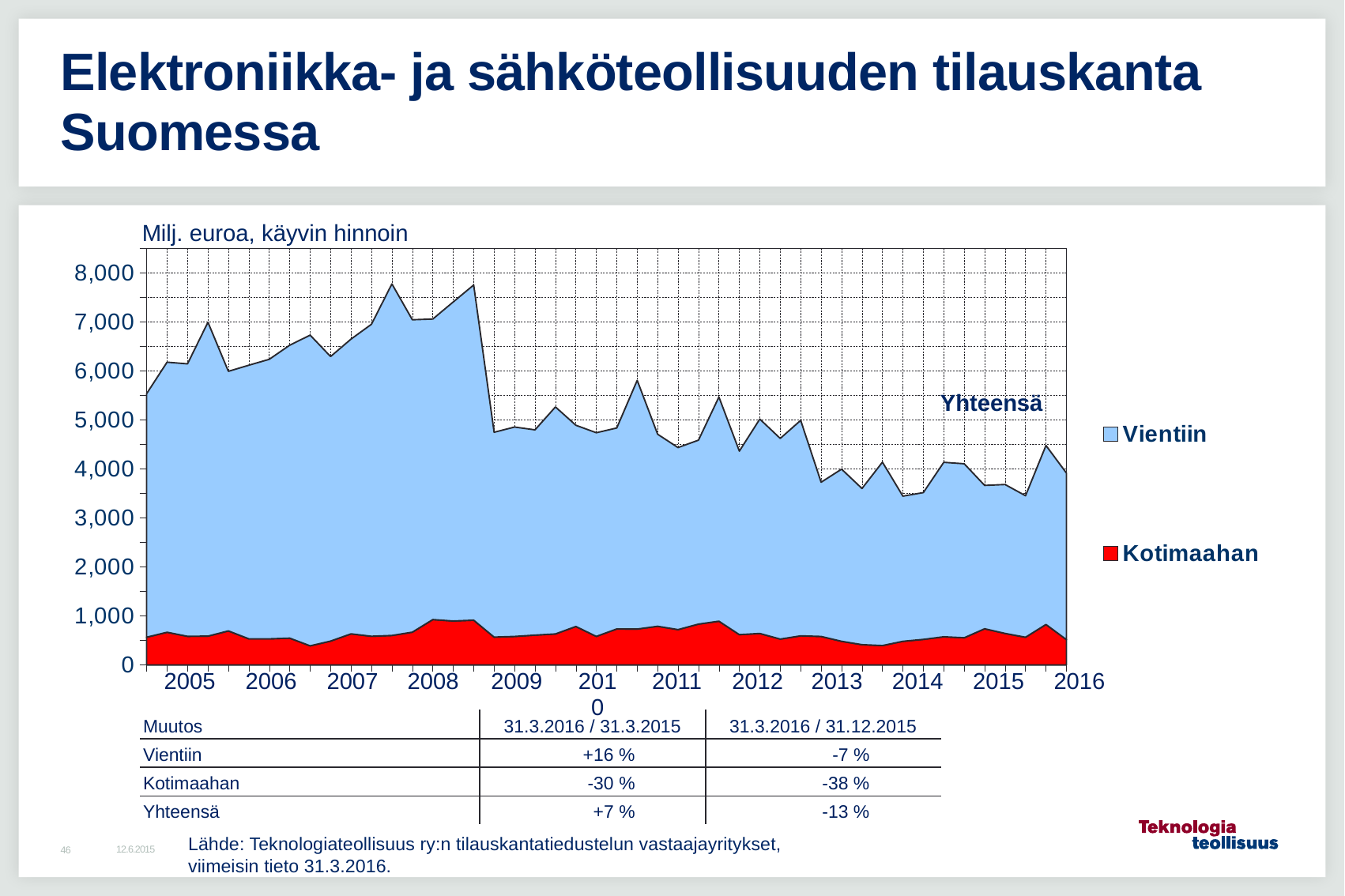
Is the total (Yhteensä) value at the start of 2005 greater or less than 5,000? greater Is the peak total (Yhteensä) value reached in 2008 greater or less than 7,000? greater Is the Kotimaahan value at the start of 2016 greater or less than 1,000? less Does the total (Yhteensä) order book generally rise or fall from 2008 to 2016? fall How many year labels are shown on the x axis of the chart? 12 How many series does the chart legend list? 2 What kind of chart is shown on the slide? area chart What unit is stated above the chart's vertical axis? Milj. euroa, käyvin hinnoin Which is larger, the total order book in 2008 or in 2016? 2008 Which two series are listed in the chart legend? Vientiin and Kotimaahan